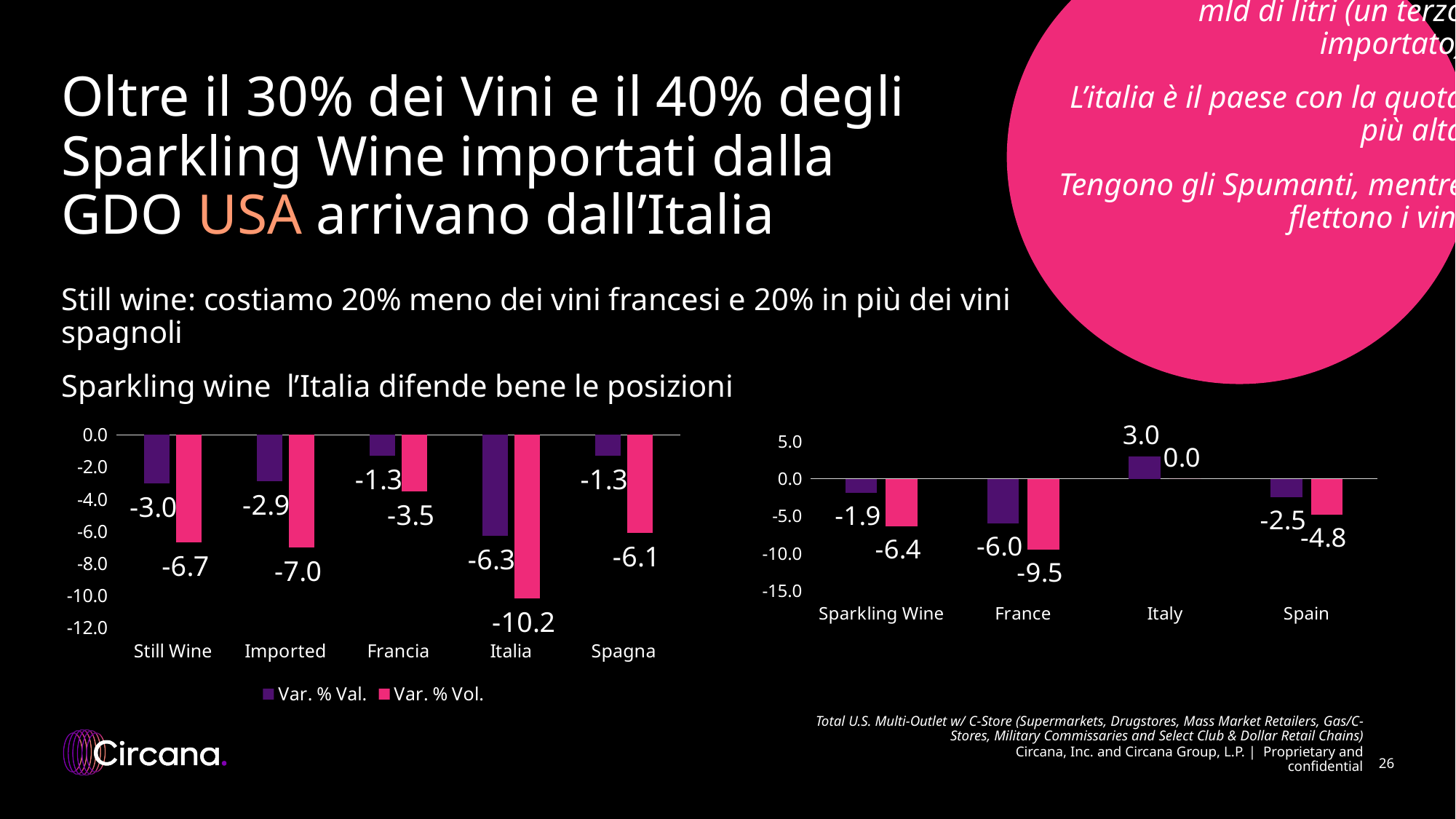
In the left chart, which category has the lowest Var. % Vol. value? Italia In the left chart, what is the Var. % Vol. value for Italia? -10.2 In the right chart, what is the value of the purple bar for Italy? 3.0 In the left chart, what is the Var. % Val. value for Imported? -2.9 What kind of chart is the left chart? Bar chart In the right chart, what is the difference between the pink bar values for Sparkling Wine and Spain? 1.6 In the left chart, what is the difference between the Var. % Val. and Var. % Vol. values for Still Wine? 3.7 How many categories are shown on the x axis of the left chart? 5 How many series does the legend of the left chart list? 2 In the left chart, which is larger, the Var. % Vol. value for Francia or for Spagna? Francia In the right chart, what is the value of the pink bar for France? -9.5 In the right chart, which category has the highest purple bar value? Italy